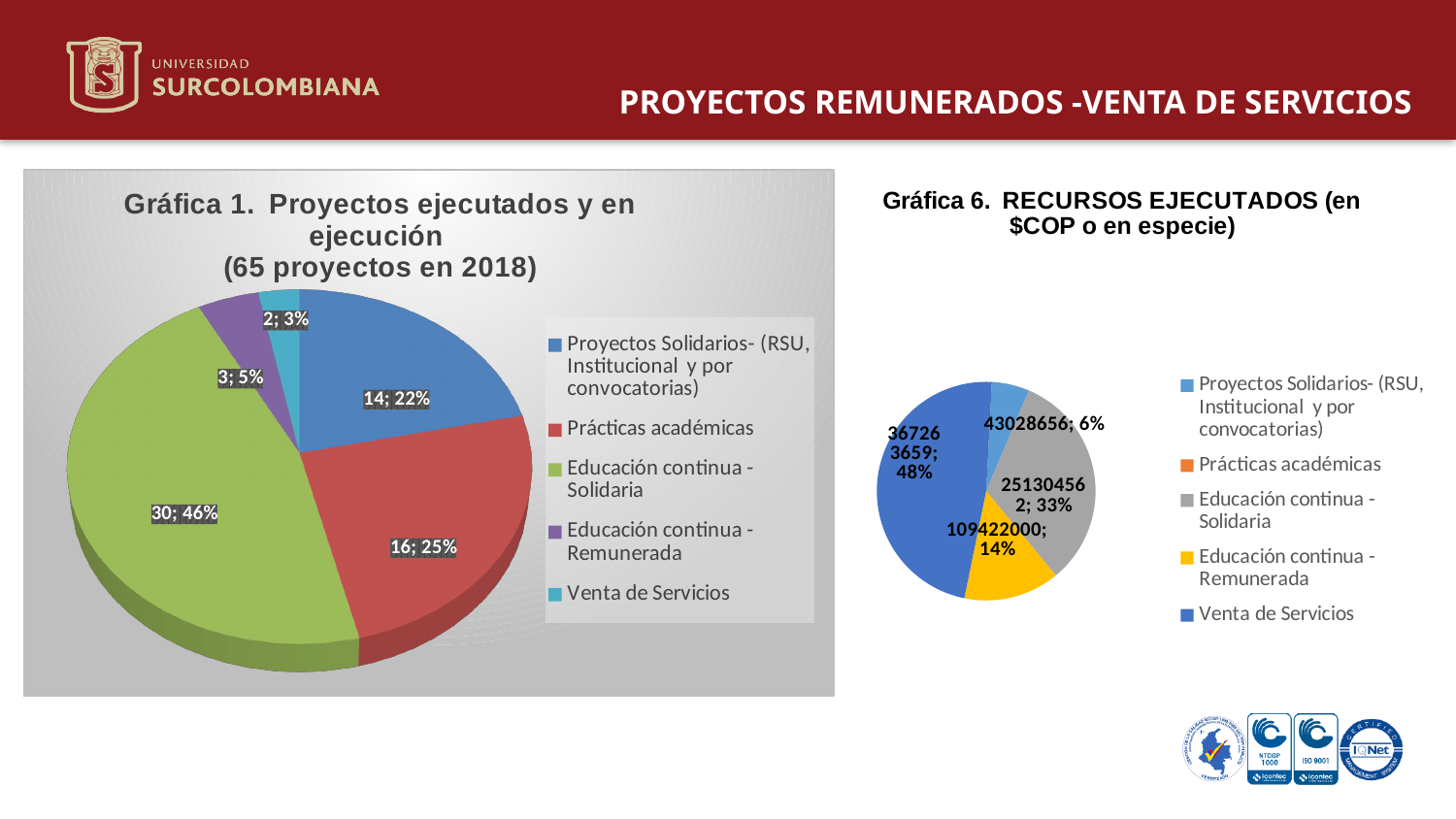
In Gráfica 6, what is the value of resources executed for Educación continua - Remunerada? 109422000 In Gráfica 1, which has more projects: Educación continua - Remunerada or Venta de Servicios? Educación continua - Remunerada How many categories does the legend of Gráfica 1 list? 5 In Gráfica 1, which category has the smallest number of projects? Venta de Servicios According to the title of Gráfica 1, how many projects were there in 2018? 65 proyectos In Gráfica 1, what percentage of projects are Prácticas académicas? 25% In Gráfica 1, which category has the largest number of projects? Educación continua - Solidaria In Gráfica 6, what share of the executed resources corresponds to Venta de Servicios? 48% What type of chart is Gráfica 1? Pie chart In Gráfica 1, what is the difference between the number of Prácticas académicas projects and Proyectos Solidarios projects? 2 In Gráfica 6, which category has the smallest share of executed resources among the slices shown? Proyectos Solidarios- (RSU, Institucional y por convocatorias) In Gráfica 1, how many projects are in the Educación continua - Solidaria category? 30